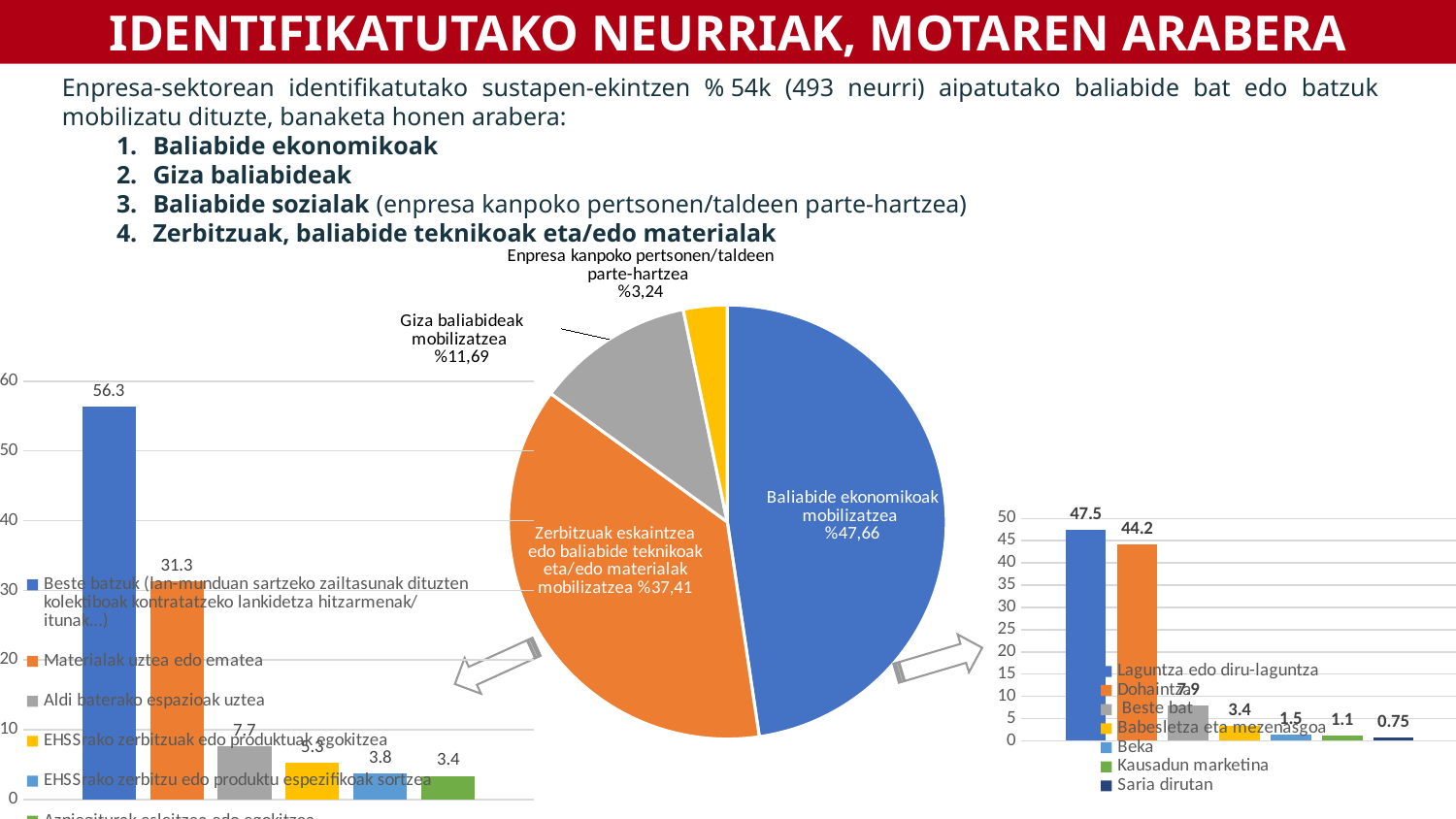
In the bar chart on the left, what is the value for 'Materialak uztea edo ematea'? 31.3 How many series does the legend of the bar chart on the right list? 7 In the bar chart on the right, what is the difference between 'Laguntza edo diru-laguntza' and 'Dohaintza'? 3.3 In the bar chart on the left, what is the highest value shown? 56.3 In the bar chart on the right, what is the value for 'Laguntza edo diru-laguntza'? 47.5 In the pie chart, which slice is the smallest? Enpresa kanpoko pertsonen/taldeen parte-hartzea In the bar chart on the right, what is the value for 'Saria dirutan'? 0.75 In the pie chart, what share is shown for 'Giza baliabideak mobilizatzea'? %11,69 How many slices does the pie chart have? 4 In the bar chart on the right, which is larger: 'Beka' or 'Kausadun marketina'? Beka What type of chart is the chart in the centre of the slide? Pie chart In the pie chart, what share is shown for 'Baliabide ekonomikoak mobilizatzea'? %47,66